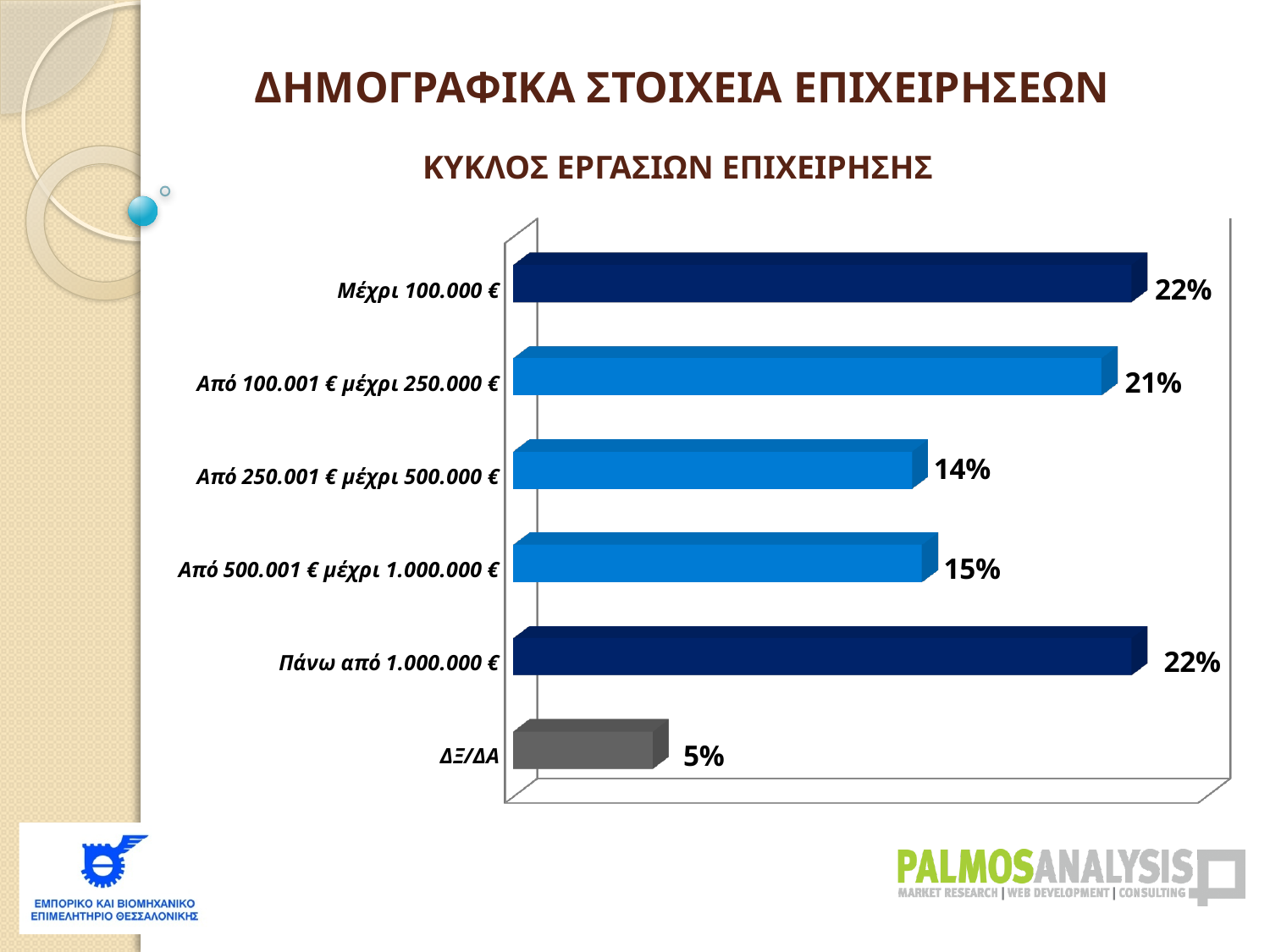
What is the value for the category 'Από 500.001 € μέχρι 1.000.000 €'? 15% What is the difference between the values for 'Πάνω από 1.000.000 €' and 'ΔΞ/ΔΑ'? 17% What kind of chart is shown on the slide? Bar chart Which is larger, the value for 'Από 500.001 € μέχρι 1.000.000 €' or the value for 'Από 250.001 € μέχρι 500.000 €'? Από 500.001 € μέχρι 1.000.000 € What is the value for the category 'Μέχρι 100.000 €'? 22% What is the value for the category 'Από 100.001 € μέχρι 250.000 €'? 21% What is the title of the chart? ΚΥΚΛΟΣ ΕΡΓΑΣΙΩΝ ΕΠΙΧΕΙΡΗΣΗΣ How many categories are shown in the chart? 6 What is the difference between the values for 'Από 100.001 € μέχρι 250.000 €' and 'Από 250.001 € μέχρι 500.000 €'? 7% What is the value for the category 'Από 250.001 € μέχρι 500.000 €'? 14% Which category has the lowest value? ΔΞ/ΔΑ What is the value for the category 'ΔΞ/ΔΑ'? 5%